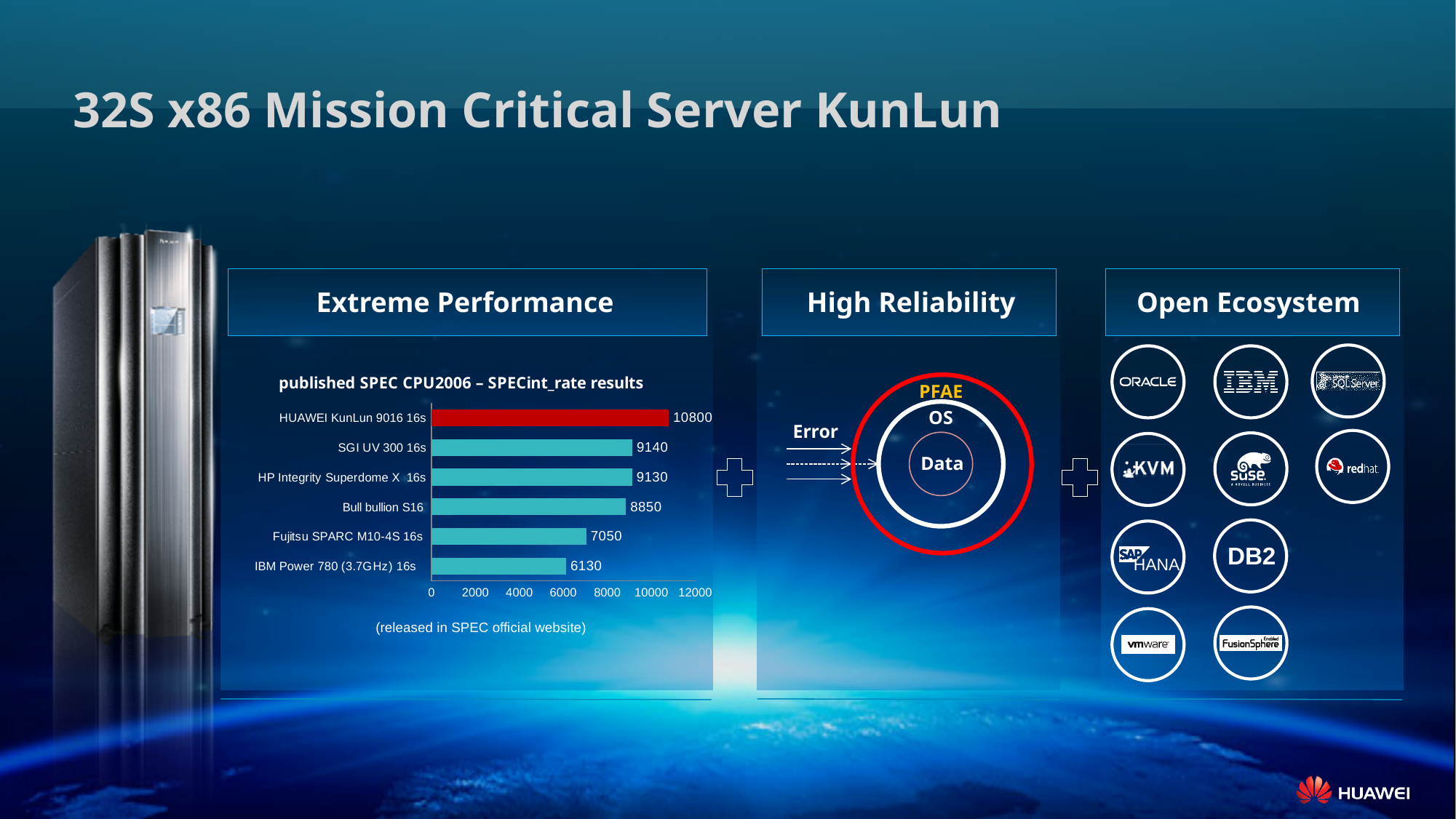
What is the difference between the Fujitsu SPARC M10-4S 16s result and the IBM Power 780 (3.7GHz) 16s result? 920 How many systems are compared in the SPEC CPU2006 chart? 6 What is the value shown for Bull bullion S16? 8850 Is the value for SGI UV 300 16s greater or less than 8000? greater Which system has the lowest SPECint_rate result in the chart? IBM Power 780 (3.7GHz) 16s What kind of chart is used to show the SPECint_rate results? Bar chart What is the title of the chart in the Extreme Performance section? published SPEC CPU2006 – SPECint_rate results What is the difference between the HUAWEI KunLun 9016 16s result and the SGI UV 300 16s result? 1660 Which has a higher SPECint_rate result, Bull bullion S16 or Fujitsu SPARC M10-4S 16s? Bull bullion S16 What is the SPECint_rate result for HUAWEI KunLun 9016 16s? 10800 What is the SPECint_rate result for IBM Power 780 (3.7GHz) 16s? 6130 Which system has the highest SPECint_rate result in the chart? HUAWEI KunLun 9016 16s